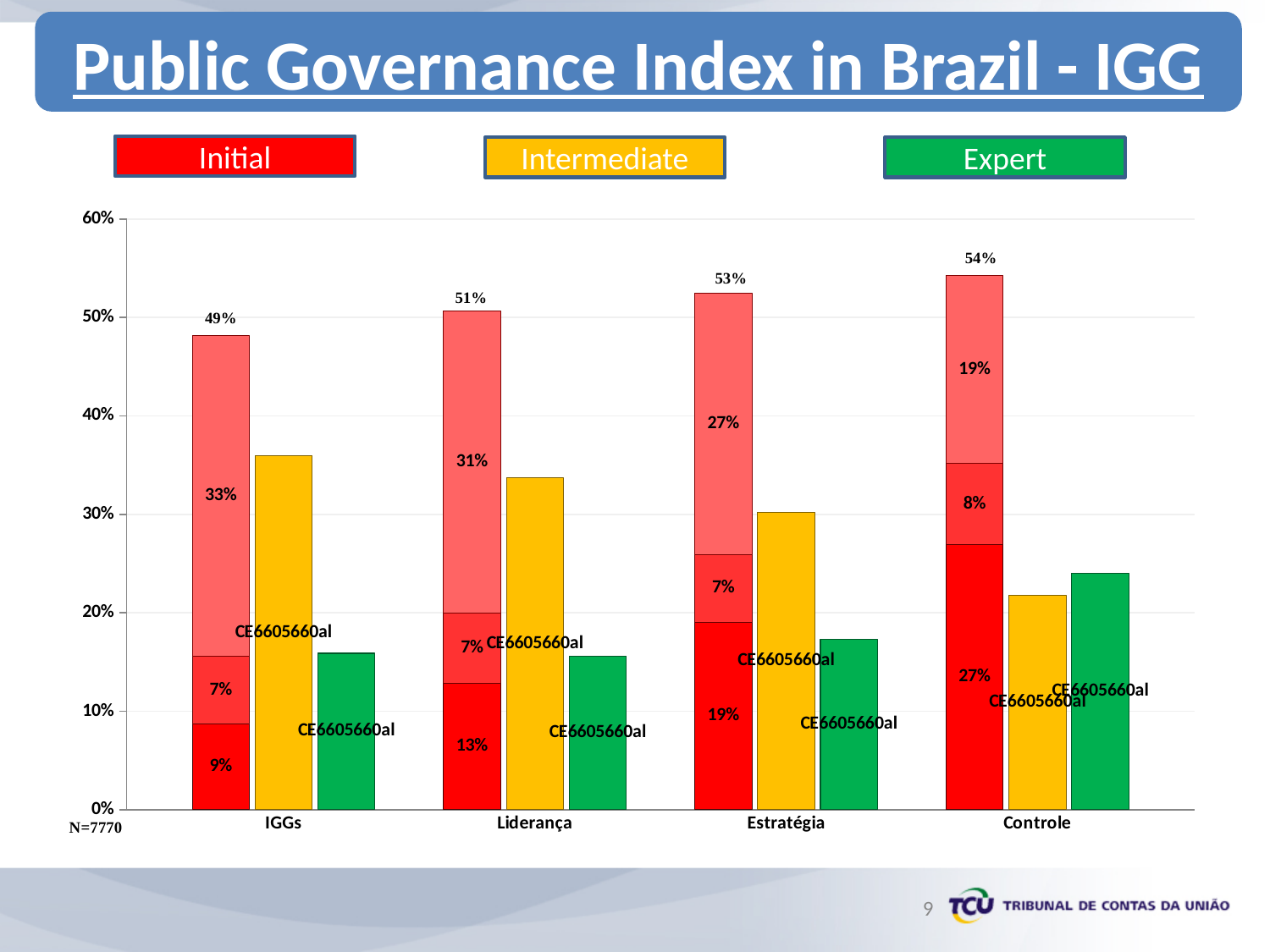
Which category has the highest total for the Initial (red) stacked bar? Controle How many categories are shown on the x axis? 4 What is the value of the bottom (darkest red) segment of the Initial bar for Estratégia? 19% What kind of chart is shown on the slide? bar chart Is the Expert (green) bar for Controle greater or less than 20%? greater Is the Intermediate (yellow) bar for IGGs greater or less than 30%? greater What is the difference between the Initial bar totals for Controle and IGGs? 5 percentage points What is the value of the top segment of the Initial bar for IGGs? 33% Which category has the lowest total for the Initial (red) stacked bar? IGGs Do the totals of the Initial (red) stacked bars rise or fall from IGGs to Controle? rise What is the total value labelled above the Initial (red) stacked bar for Controle? 54% Which is larger, the Intermediate (yellow) bar for IGGs or the Intermediate bar for Controle? IGGs